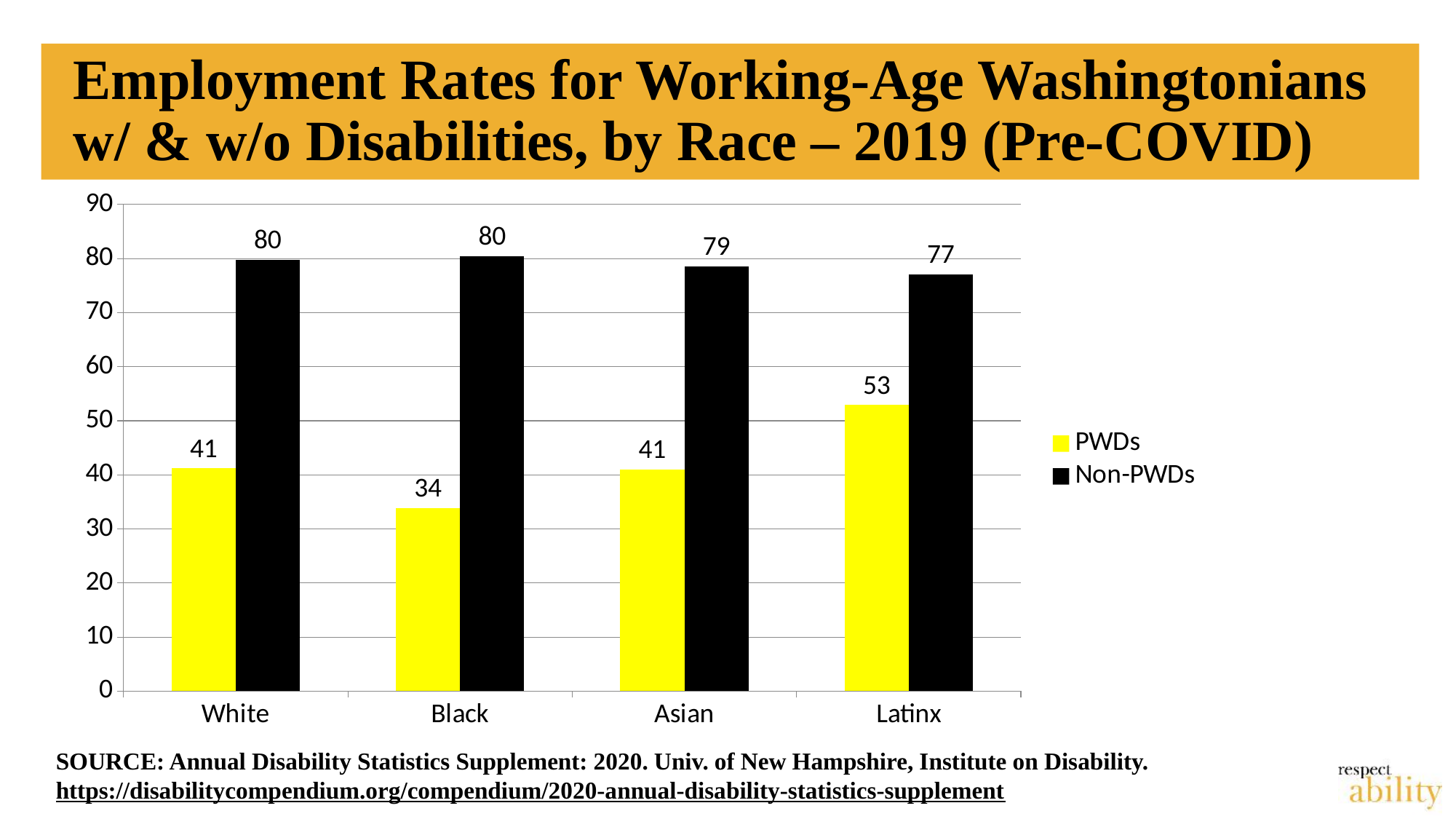
Which race category has the highest employment rate for PWDs? Latinx Which is larger, the PWDs employment rate for Latinx or for Asian? Latinx Which race category has the lowest employment rate for Non-PWDs? Latinx What is the employment rate for PWDs in the White category? 41 What is the employment rate for Non-PWDs in the Latinx category? 77 What kind of chart is shown on the slide? Bar chart What is the difference between the Non-PWDs and PWDs employment rates in the Black category? 46 What is the difference between the Non-PWDs and PWDs employment rates in the Latinx category? 24 What is the employment rate for PWDs in the Black category? 34 How many race categories are shown on the x axis? 4 How many series does the legend list? 2 Which race category has the lowest employment rate for PWDs? Black